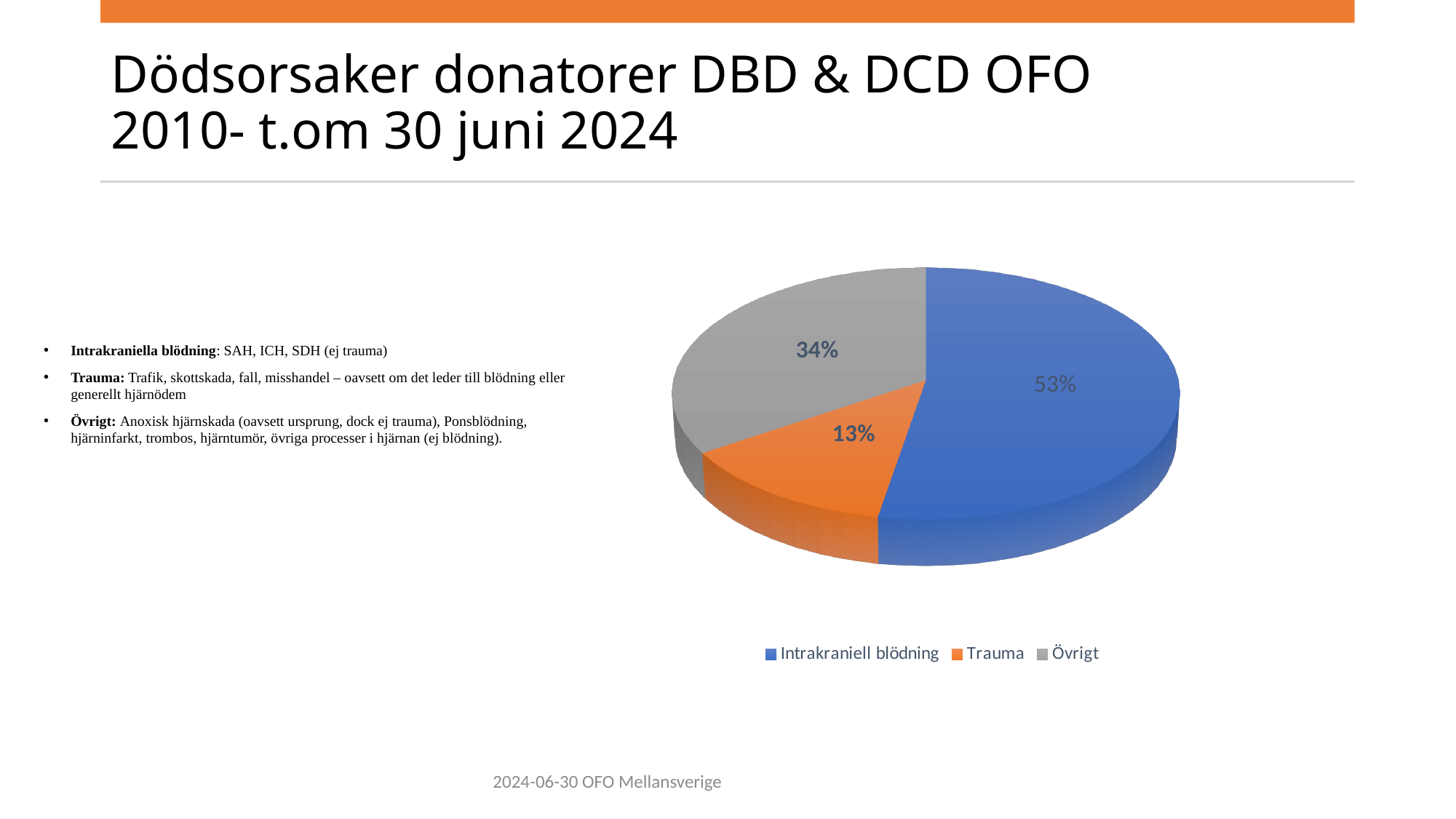
What share of the pie does Övrigt account for? 34% What kind of chart is shown on the slide? Pie chart Which is larger, the share for Övrigt or the share for Trauma? Övrigt How many categories does the pie chart show? 3 What is the difference in percentage points between Övrigt and Trauma? 21 What are the three legend entries of the pie chart? Intrakraniell blödning, Trauma, Övrigt Which category has the smallest slice of the pie? Trauma What share of the pie does Intrakraniell blödning account for? 53% Which colour represents Trauma in the pie chart? Orange What share of the pie does Trauma account for? 13% Which category has the largest slice of the pie? Intrakraniell blödning What is the difference in percentage points between Intrakraniell blödning and Övrigt? 19